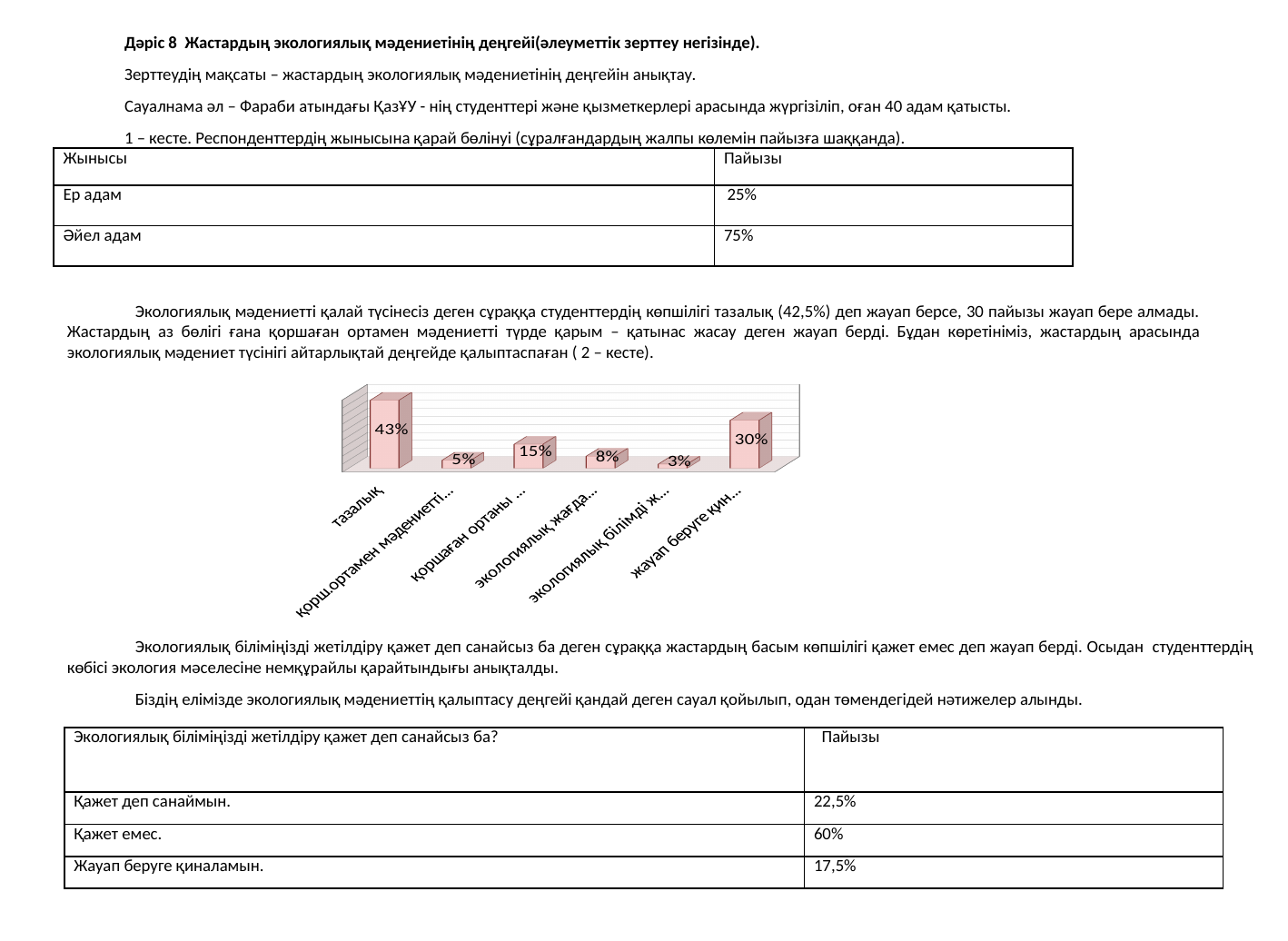
What is the value for the category "экологиялық білімді ж..." in the bar chart? 3% What is the value for the category "экологиялық жағда..." in the bar chart? 8% What is the value for the category "қоршаған ортаны ..." in the bar chart? 15% Which category has the lowest value in the bar chart? экологиялық білімді ж... How many categories does the bar chart show? 6 What is the difference between the values for "қорш.ортамен мәдениетті..." and "экологиялық білімді ж..." in the bar chart? 2% What is the difference between the values for "тазалық" and "жауап беруге қин..." in the bar chart? 13% Which category has the highest value in the bar chart? тазалық Which is larger in the bar chart: the value for "қоршаған ортаны ..." or the value for "экологиялық жағда..."? қоршаған ортаны ... What kind of chart is shown on the slide? bar chart What is the value for the category "тазалық" in the bar chart? 43% What is the value for the category "жауап беруге қин..." in the bar chart? 30%